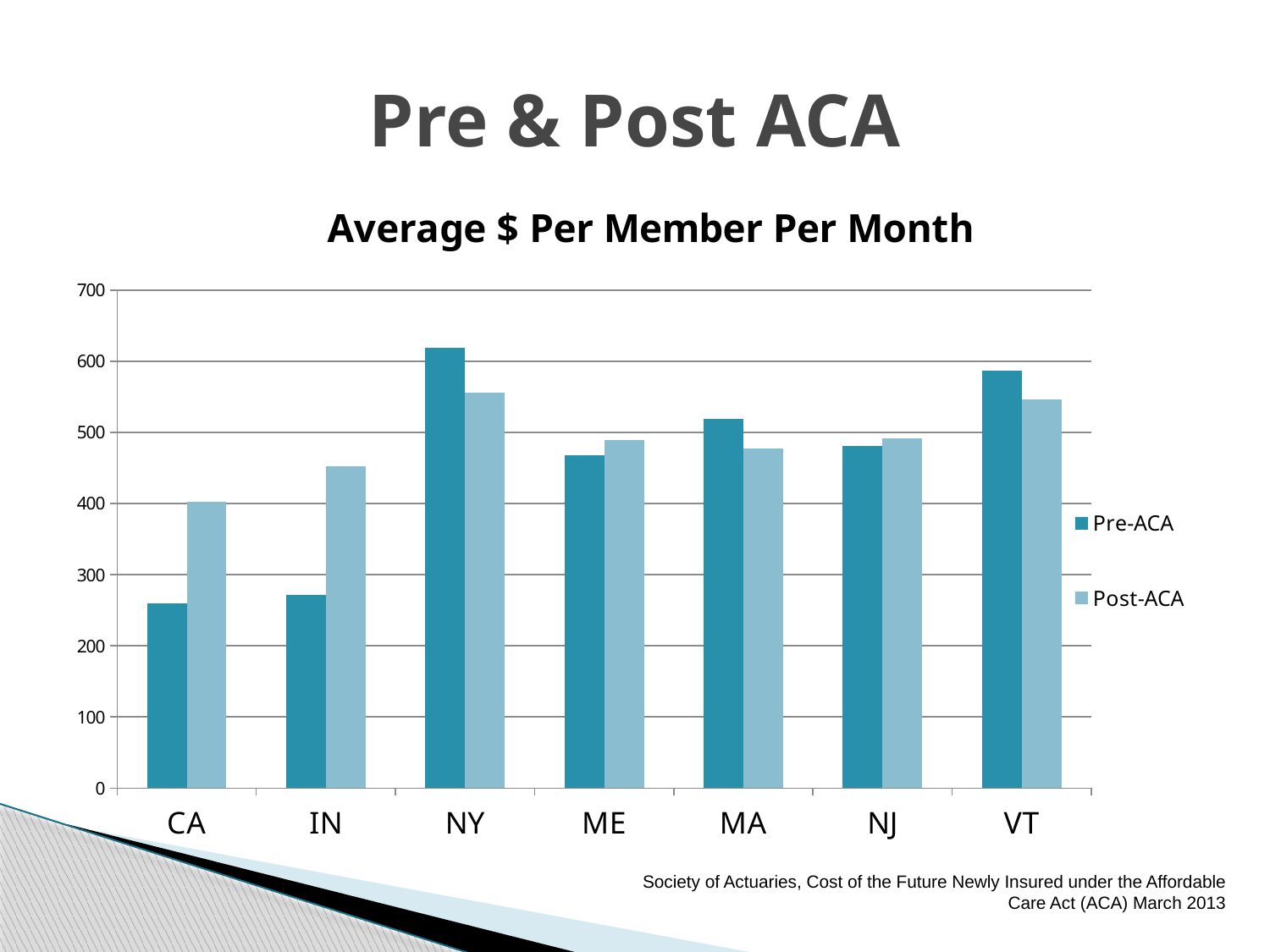
What kind of chart is shown on the slide? bar chart For CA, which is larger, the Pre-ACA or the Post-ACA value? Post-ACA How many series does the legend list? 2 Is the Pre-ACA value for CA greater or less than 300? less How many states are shown on the x axis? 7 Is the Post-ACA value for VT greater or less than 500? greater What is the title of the chart? Average $ Per Member Per Month For MA, which is larger, the Pre-ACA or the Post-ACA value? Pre-ACA Which state has the lowest Post-ACA value? CA Is the Post-ACA value for IN greater or less than 400? greater Which state has the highest Pre-ACA value? NY